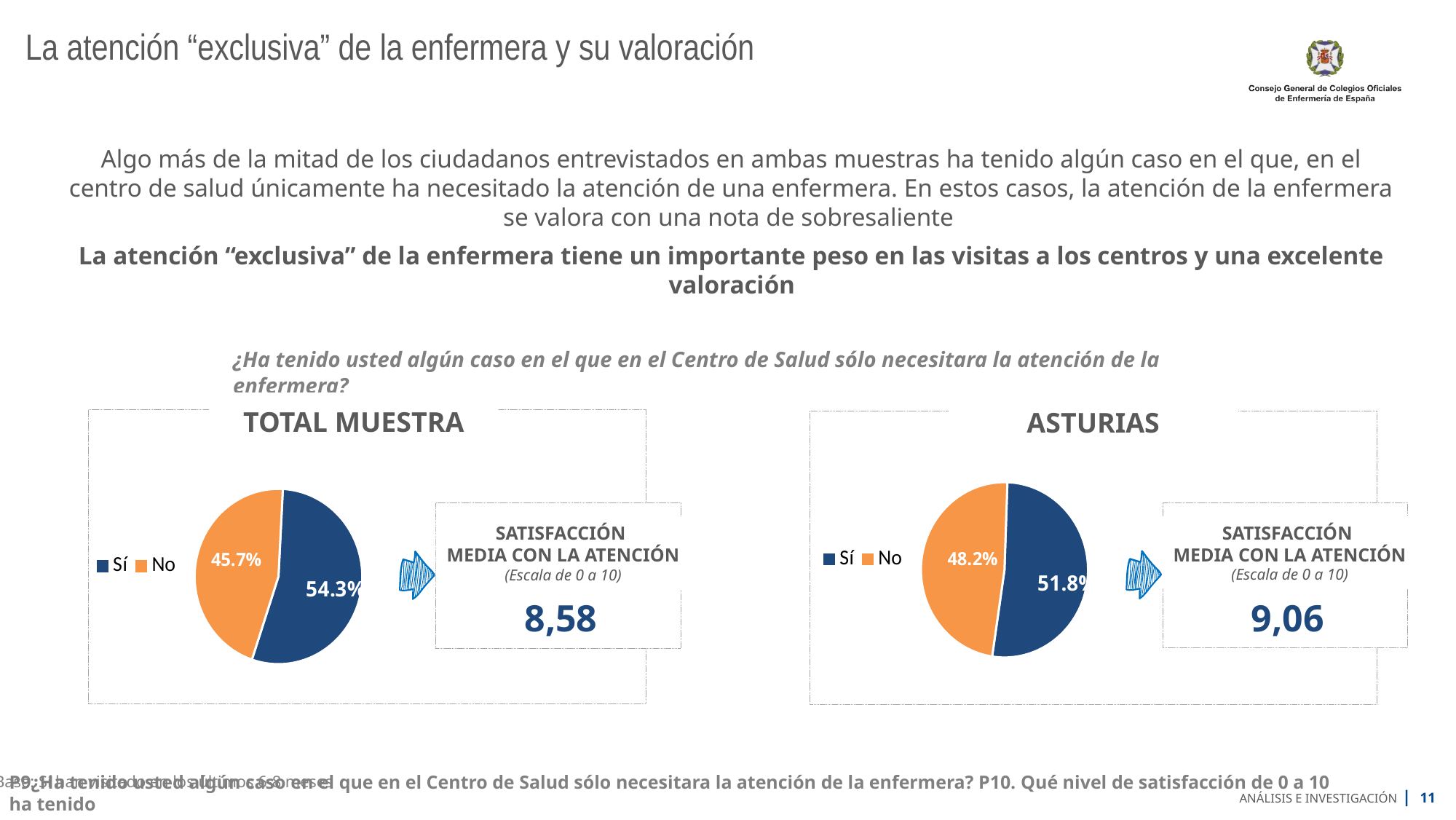
Is the Sí value larger in the TOTAL MUESTRA pie chart or in the ASTURIAS pie chart? TOTAL MUESTRA In the ASTURIAS pie chart, what is the value for No? 48.2% In the TOTAL MUESTRA pie chart, what is the value for Sí? 54.3% In the TOTAL MUESTRA pie chart, what is the difference between the Sí and No slices? 8.6 percentage points In the TOTAL MUESTRA pie chart, what is the value for No? 45.7% In the TOTAL MUESTRA pie chart, which slice is the largest? Sí In the ASTURIAS pie chart, which slice is the smallest? No In the ASTURIAS pie chart, what is the value for Sí? 51.8% What type of chart is used for TOTAL MUESTRA and ASTURIAS? Pie chart How many entries does the legend of the ASTURIAS pie chart list? 2 In the TOTAL MUESTRA pie chart, what colour is the No slice? Orange In the ASTURIAS pie chart, what is the difference between the Sí and No slices? 3.6 percentage points